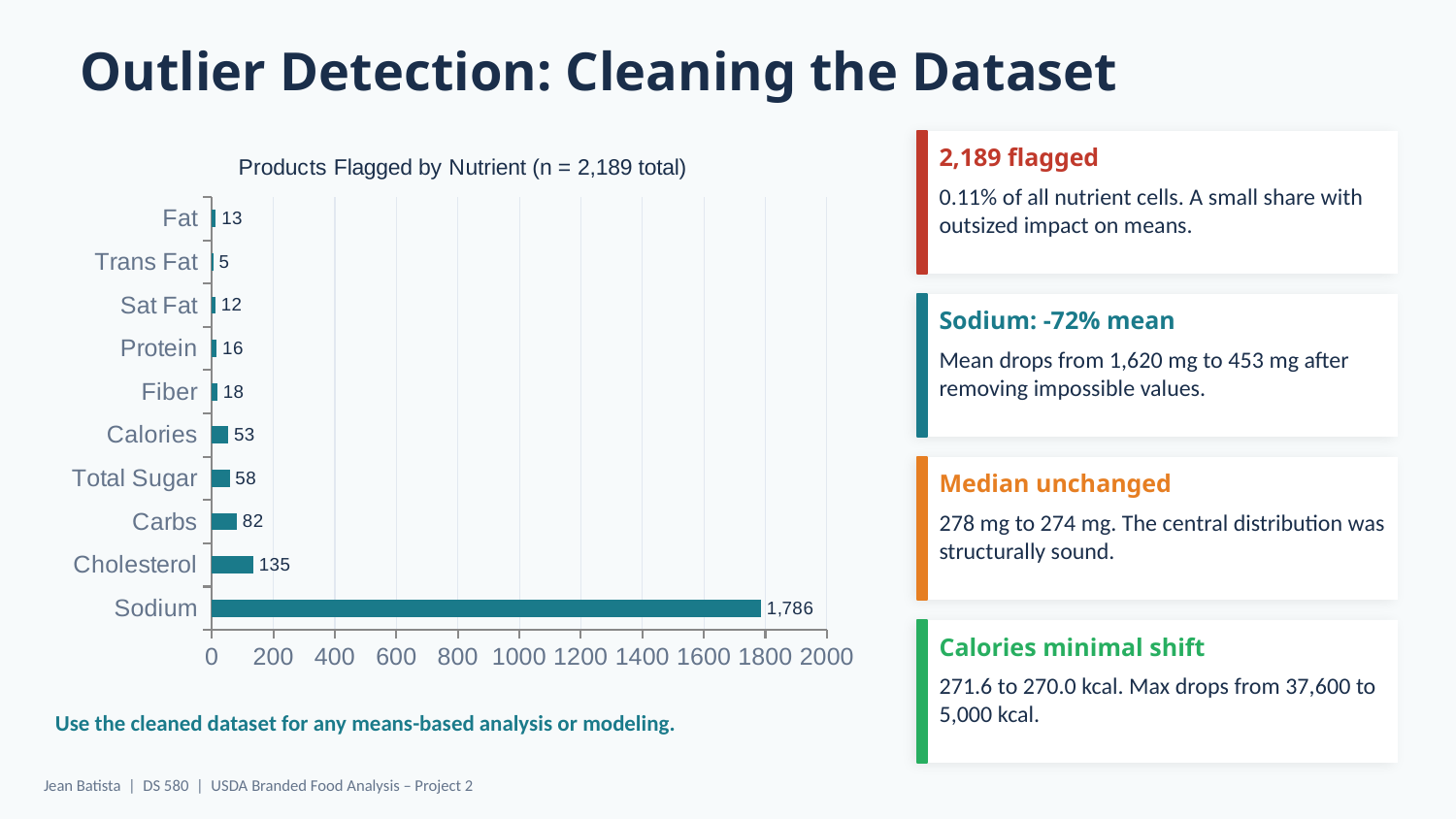
What is the title of the chart? Products Flagged by Nutrient (n = 2,189 total) Is the value for Sodium greater or less than 1600? greater What is the value for Fiber? 18 Which is larger, the value for Calories or the value for Total Sugar? Total Sugar How many nutrient categories are shown in the chart? 10 What kind of chart is shown on the slide? Bar chart What is the value for Trans Fat? 5 Which nutrient has the highest number of flagged products? Sodium What is the value for Sodium? 1,786 What is the value for Cholesterol? 135 Which nutrient has the lowest number of flagged products? Trans Fat What is the difference between the values for Cholesterol and Carbs? 53